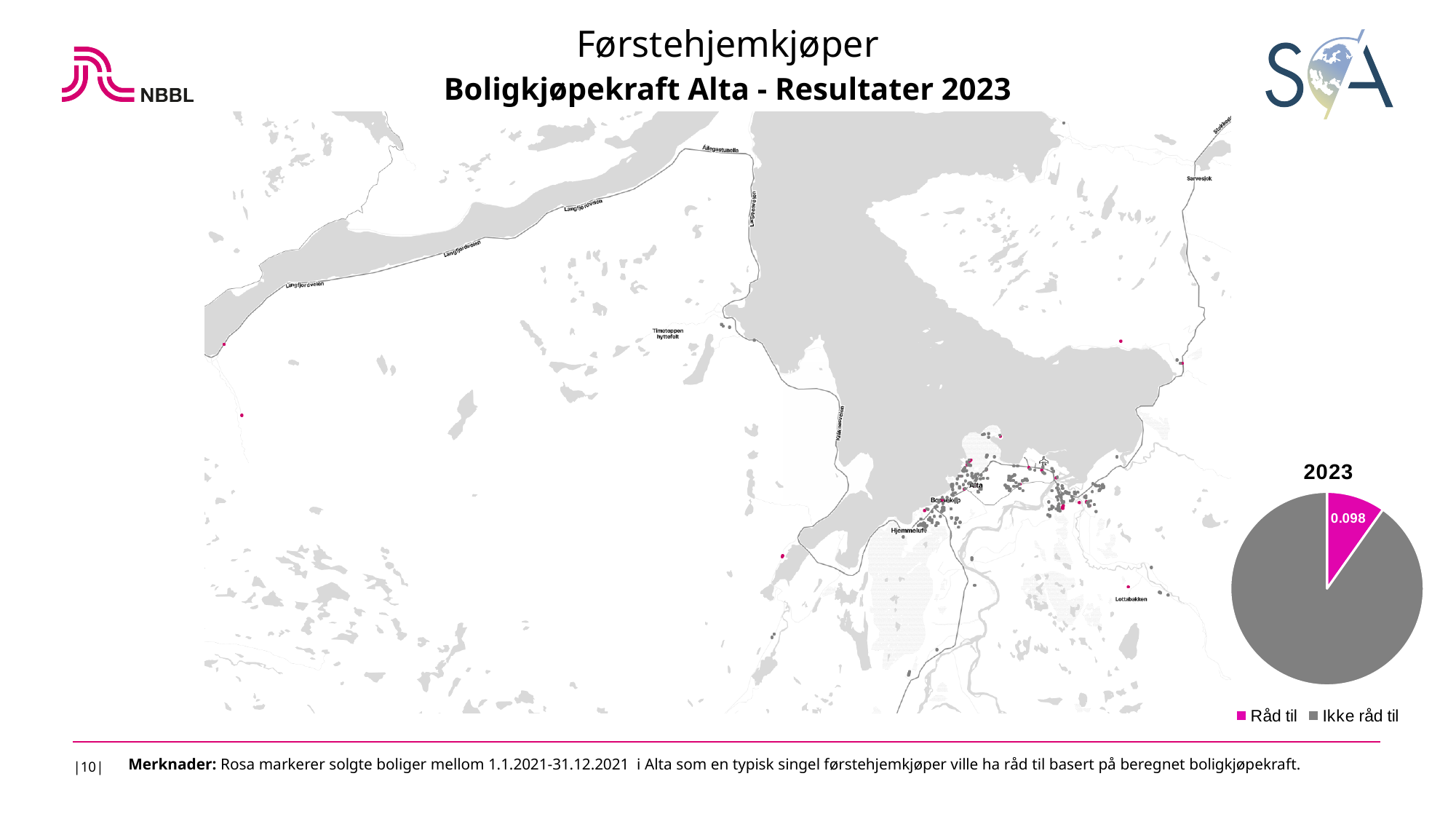
In the pie chart titled "2023", which category has the smallest slice? Råd til In the pie chart titled "2023", which category has the largest slice? Ikke råd til In the pie chart titled "2023", which slice is larger, "Råd til" or "Ikke råd til"? Ikke råd til How many entries does the legend of the pie chart titled "2023" list? 2 In the pie chart titled "2023", what colour is the "Råd til" slice? pink How many slices does the pie chart titled "2023" have? 2 What kind of chart is the chart titled "2023" on the right of the slide? pie chart In the pie chart titled "2023", what value is shown for "Råd til"? 0.098 What is the title of the pie chart on the right of the slide? 2023